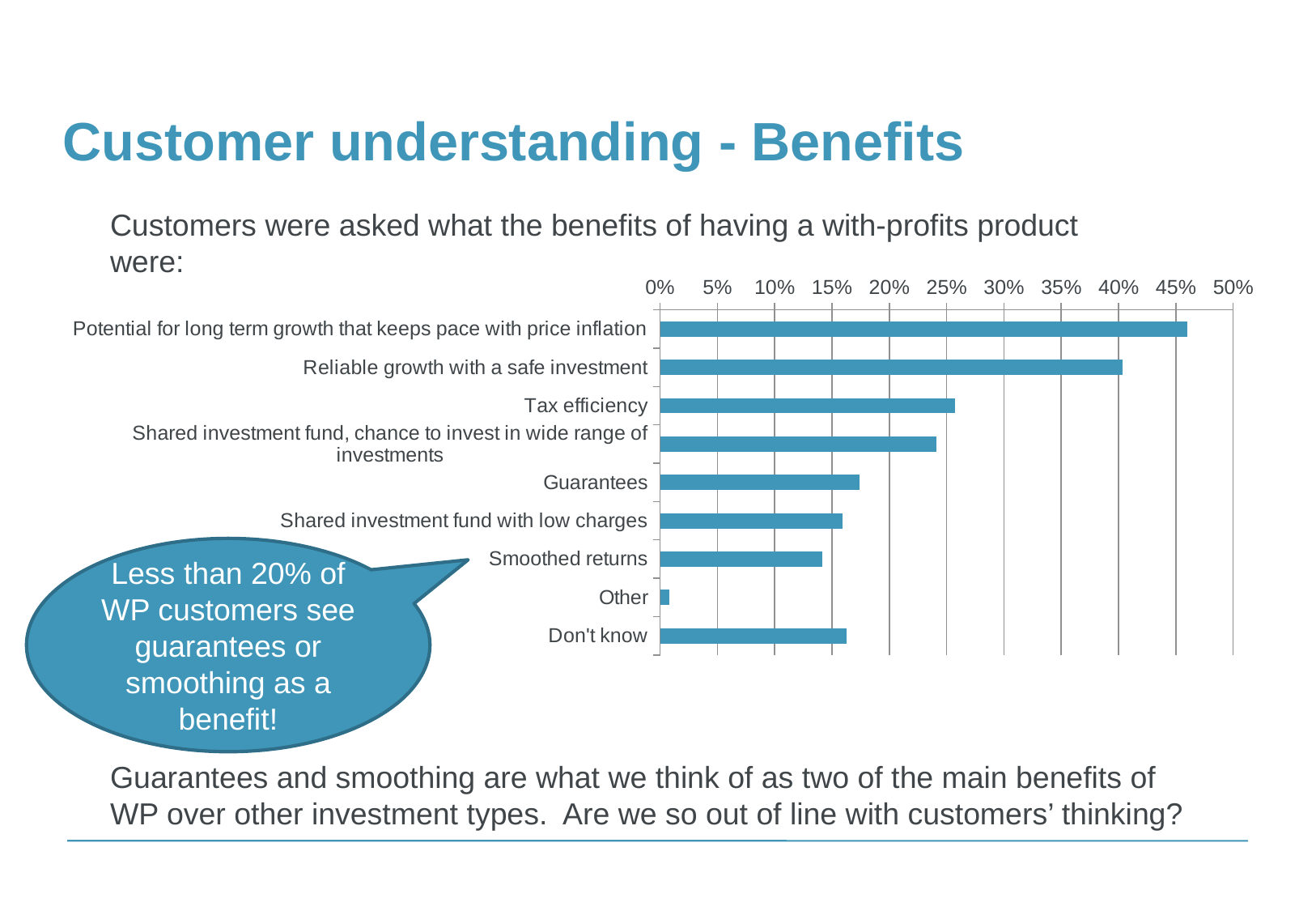
Which category has the lowest value in the chart? Other Which category has the highest value in the chart? Potential for long term growth that keeps pace with price inflation What is the maximum value shown on the percentage axis of the chart? 50% Which has the larger value, 'Guarantees' or 'Smoothed returns'? Guarantees Which has the larger value, 'Reliable growth with a safe investment' or 'Tax efficiency'? Reliable growth with a safe investment Is the value for 'Potential for long term growth that keeps pace with price inflation' greater or less than 40%? greater How many categories (benefits) are plotted in the chart? 9 Is the value for 'Guarantees' greater or less than 20%? less Is the value for 'Other' greater or less than 5%? less What kind of chart is shown on the slide? Bar chart